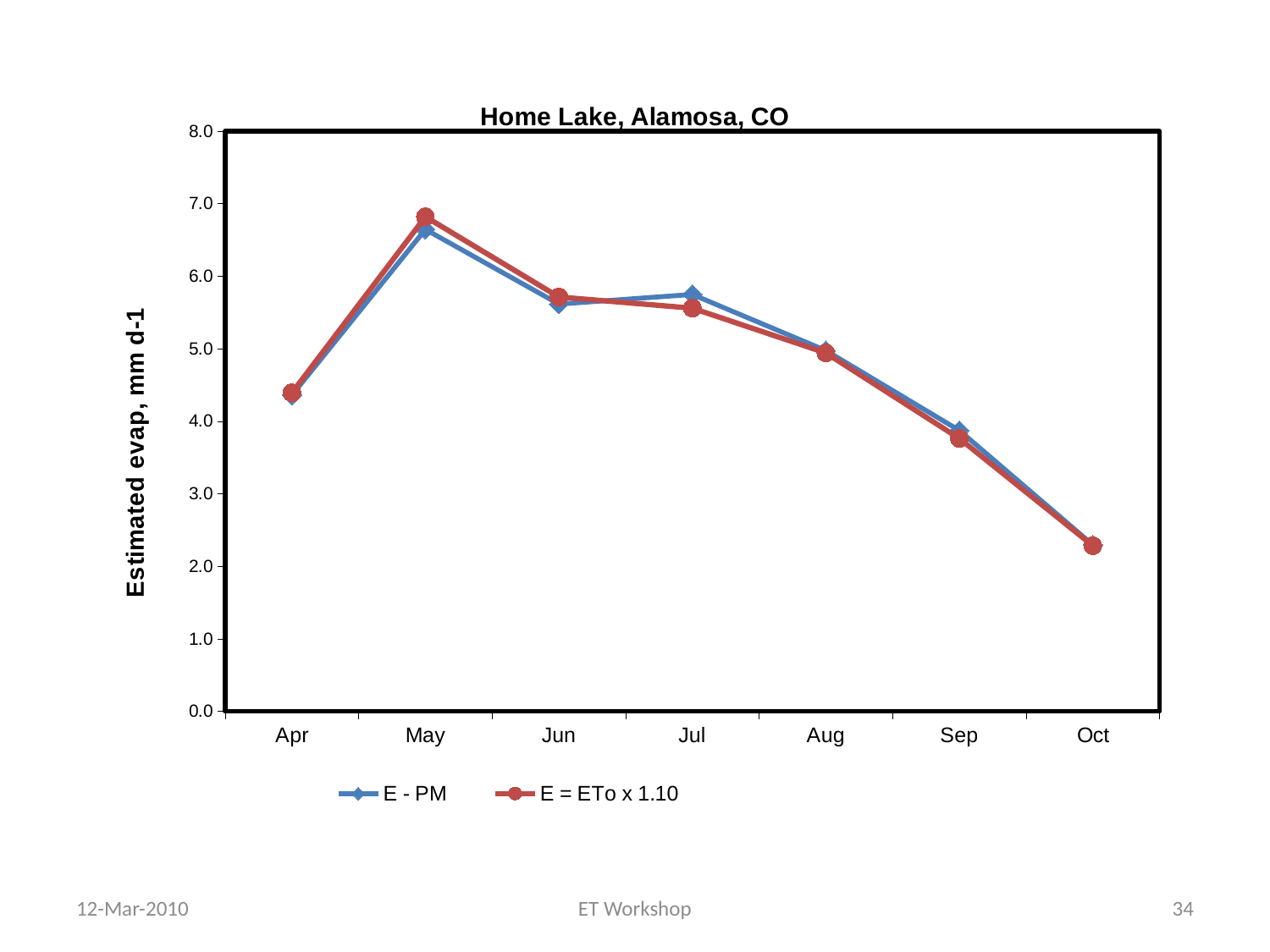
Is the value for E - PM in Apr greater or less than 4.0? greater In which month does the E - PM series reach its highest value? May How many series does the legend list? 2 Is the value for E - PM in May greater or less than 6.0? greater What is the title of the chart? Home Lake, Alamosa, CO How many months are plotted along the x axis? 7 Do the values of the E - PM series rise or fall from May to Oct? fall Is the value for E = ETo x 1.10 in Sep greater or less than 4.0? less In which month does the E = ETo x 1.10 series reach its lowest value? Oct Which is larger for the E - PM series, the value in May or the value in Oct? May What kind of chart is shown on the slide? line chart